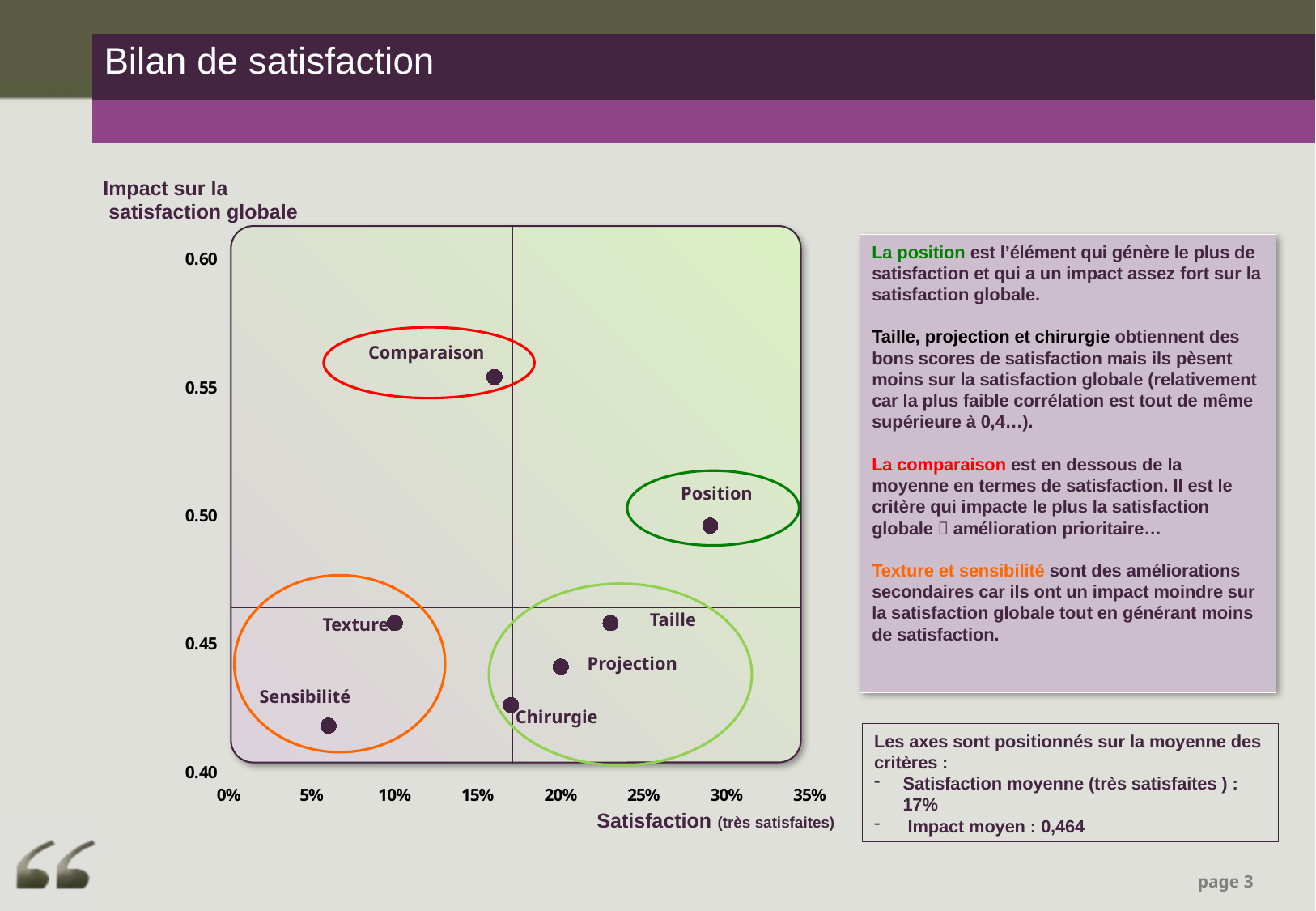
Which criterion has the highest satisfaction value (furthest right on the x axis)? Position Is the impact value for Sensibilité greater or less than 0.45? less Is the satisfaction value for Comparaison greater or less than 20%? less Which criterion has the highest impact on overall satisfaction (highest point on the y axis)? Comparaison What is the label of the vertical axis of the chart? Impact sur la satisfaction globale Which criterion has the lowest impact on overall satisfaction? Sensibilité Which has the higher satisfaction value, Position or Taille? Position Which criterion has the lowest satisfaction value? Sensibilité What kind of chart is shown on the slide? Scatter plot How many criteria (points) are plotted on the chart? 7 Is the satisfaction value for Texture greater or less than 15%? less